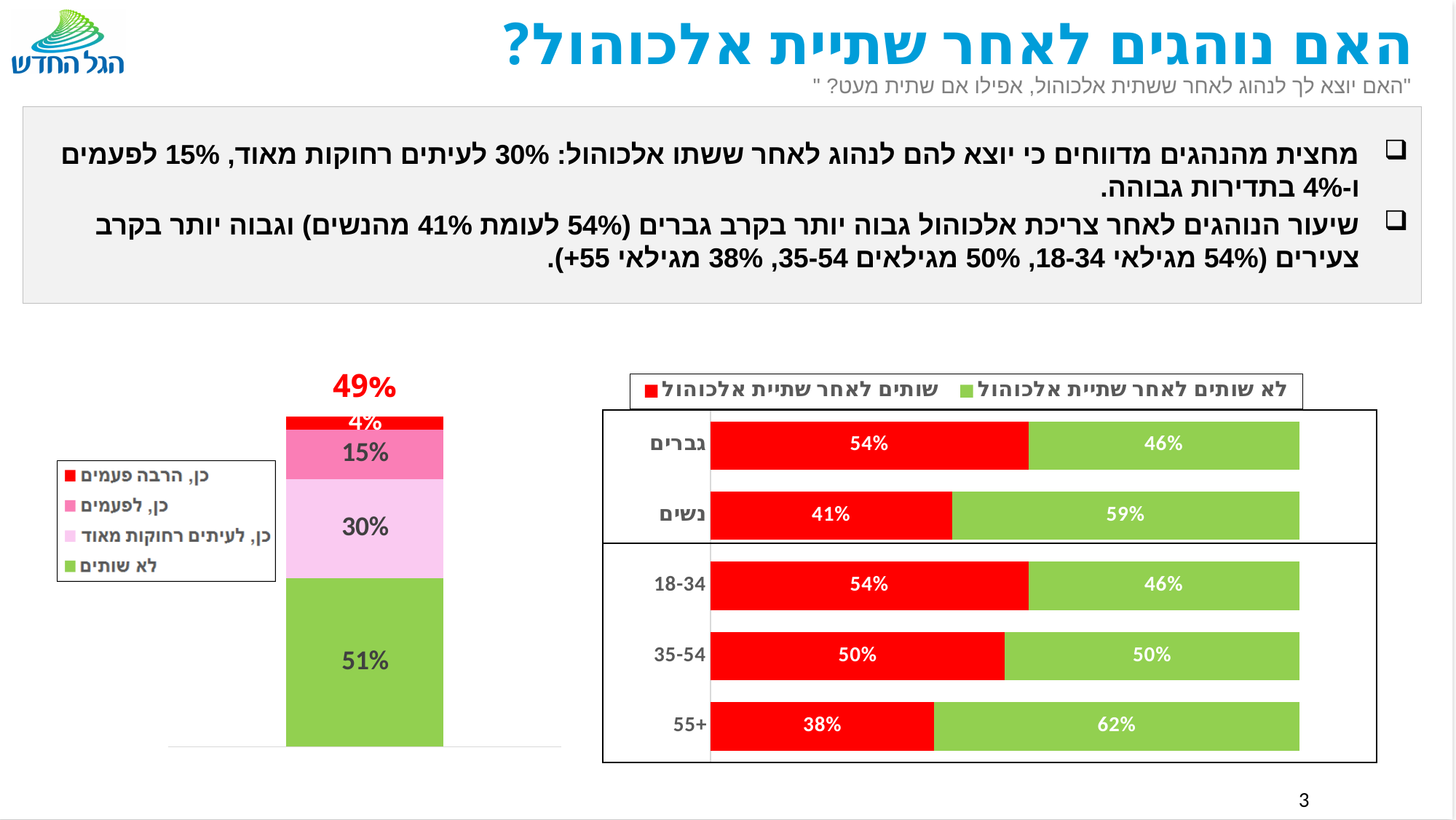
How many categories (bars) are shown in the right chart? 5 In the left stacked bar chart, which legend category has the smallest segment? כן, הרבה פעמים In the right chart, what is the value of the green segment for the 55+ group? 62% In the left stacked bar chart, what is the value of the segment for "כן, לפעמים"? 15% How many entries does the legend of the left chart list? 4 In the left stacked bar chart, which legend category has the largest segment? לא שותים In the right chart, what is the difference between the red-segment values for גברים and נשים? 13 percentage points In the right chart, which age group has the highest red-segment value? 18-34 In the right chart, what is the value of the red segment for גברים? 54% What kind of chart is the chart on the right side of the slide? Stacked bar chart In the right chart, which has the larger red-segment value: נשים or 55+? נשים In the left stacked bar chart, what is the value of the green segment labelled "לא שותים"? 51%